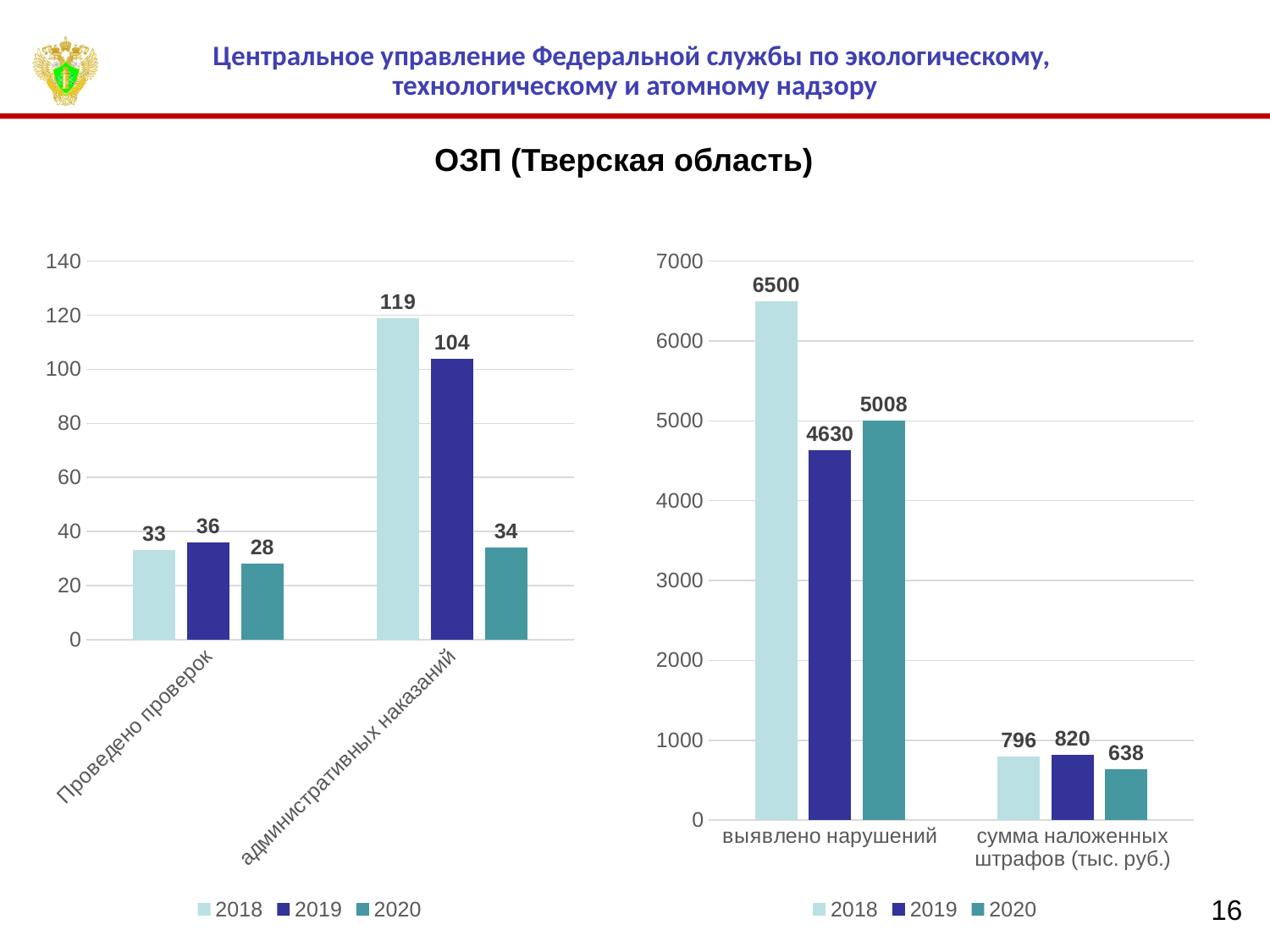
On the left chart, what is the difference between the 2018 and 2019 values for "административных наказаний"? 15 On the right chart, what is the value for 2020 in the category "сумма наложенных штрафов (тыс. руб.)"? 638 On the left chart, what is the value for 2020 in the category "Проведено проверок"? 28 On the right chart, which year has the highest value for "выявлено нарушений"? 2018 On the right chart, what is the difference between the 2020 and 2019 values for "выявлено нарушений"? 378 On the right chart, which is larger for "сумма наложенных штрафов (тыс. руб.)": the 2018 value or the 2019 value? 2019 What kind of chart is the right chart? bar chart On the left chart, what is the value for 2019 in the category "административных наказаний"? 104 On the right chart, what is the value for 2018 in the category "выявлено нарушений"? 6500 How many series does the legend of the left chart list? 3 On the left chart, which year has the lowest value for "административных наказаний"? 2020 How many categories are shown on the x axis of the right chart? 2